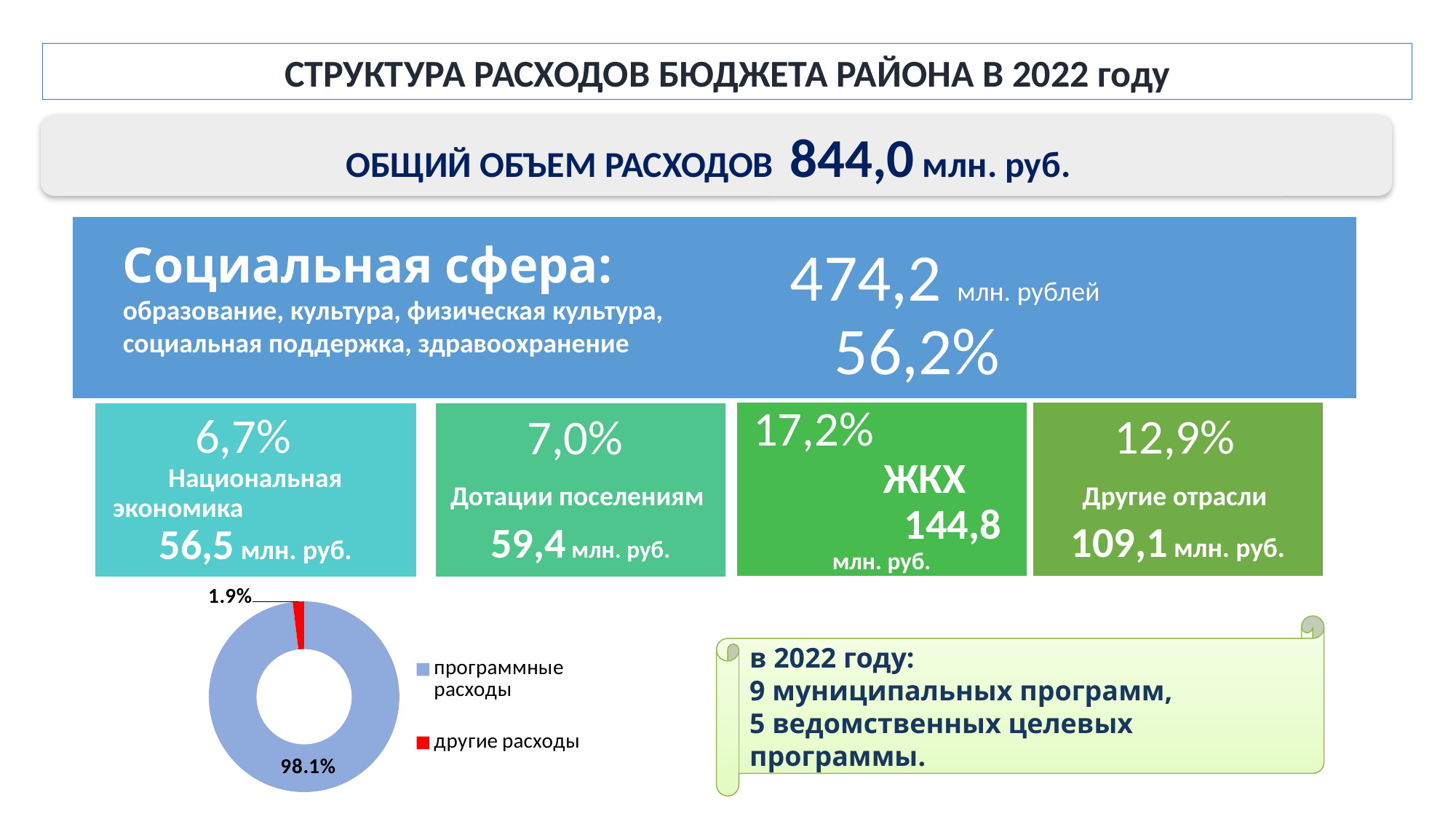
In the doughnut chart, which is larger: программные расходы or другие расходы? программные расходы What colour is the другие расходы slice in the doughnut chart? red What kind of chart is shown at the bottom left of the slide? doughnut chart Which slice of the doughnut chart is the smallest? другие расходы What colour is the программные расходы slice in the doughnut chart? light blue Which slice of the doughnut chart is the largest? программные расходы How many entries does the legend of the doughnut chart list? 2 In the doughnut chart, what share is labelled for другие расходы? 1.9% How many slices does the doughnut chart have? 2 In the doughnut chart, by how many percentage points does программные расходы exceed другие расходы? 96.2 In the doughnut chart, what share is labelled for программные расходы? 98.1%